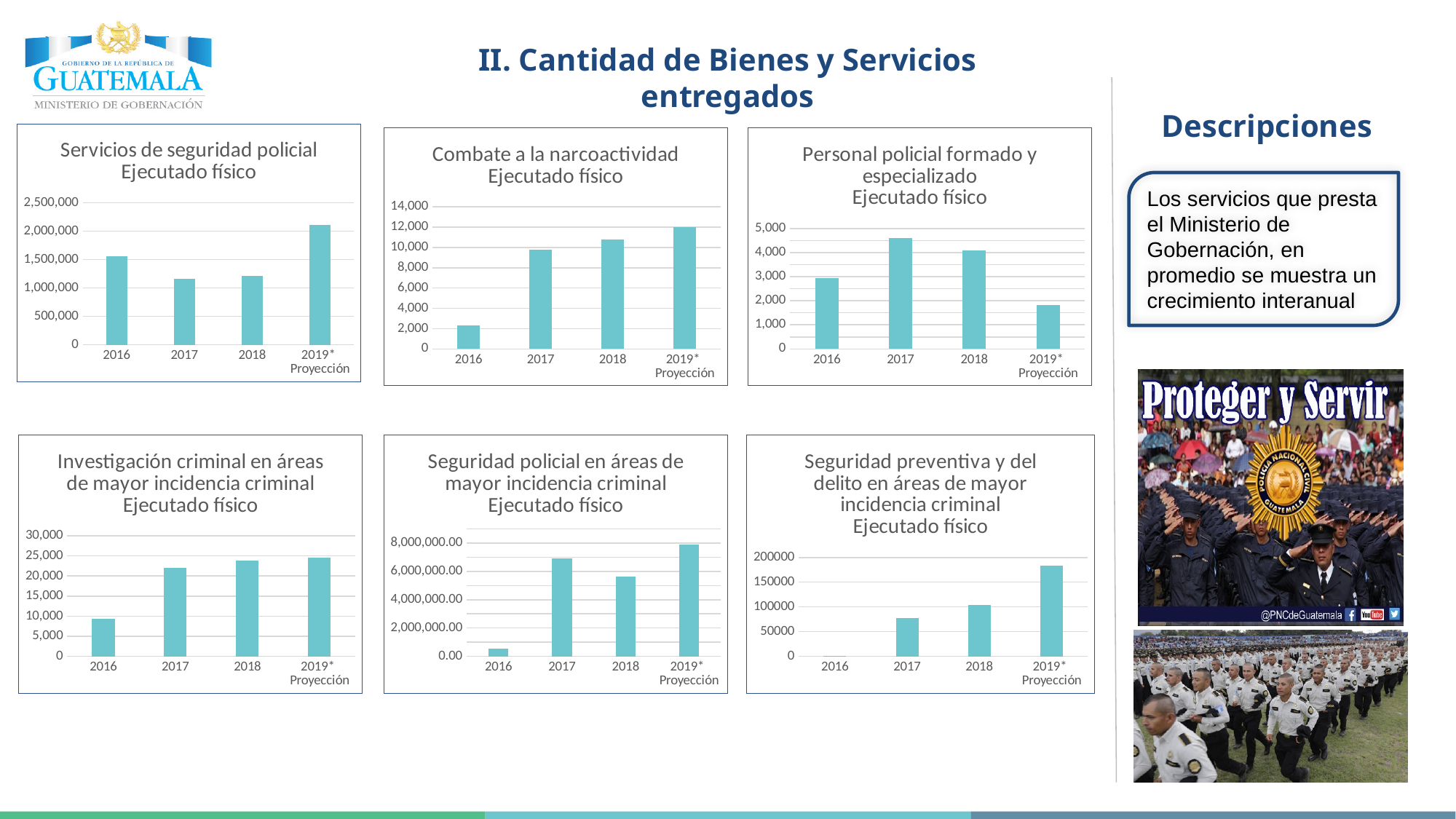
In the chart titled 'Servicios de seguridad policial Ejecutado físico', is the value for 2017 greater or less than 1,500,000? less In the chart titled 'Servicios de seguridad policial Ejecutado físico', which year has the highest value? 2019* Proyección What kind of chart is the chart titled 'Combate a la narcoactividad Ejecutado físico'? bar chart In the chart titled 'Combate a la narcoactividad Ejecutado físico', which year has the lowest value? 2016 In the chart titled 'Seguridad preventiva y del delito en áreas de mayor incidencia criminal Ejecutado físico', is the value for 2019* Proyección greater or less than 150000? greater In the chart titled 'Personal policial formado y especializado Ejecutado físico', which year has the highest value? 2017 In the chart titled 'Seguridad policial en áreas de mayor incidencia criminal Ejecutado físico', which is larger, the value for 2017 or the value for 2018? 2017 In the chart titled 'Seguridad policial en áreas de mayor incidencia criminal Ejecutado físico', which year has the lowest value? 2016 In the chart titled 'Investigación criminal en áreas de mayor incidencia criminal Ejecutado físico', is the value for 2016 greater or less than 10,000? less How many categories are shown on the x axis of the chart titled 'Seguridad preventiva y del delito en áreas de mayor incidencia criminal Ejecutado físico'? 4 In the chart titled 'Combate a la narcoactividad Ejecutado físico', do the values rise or fall from 2016 to 2019*? rise